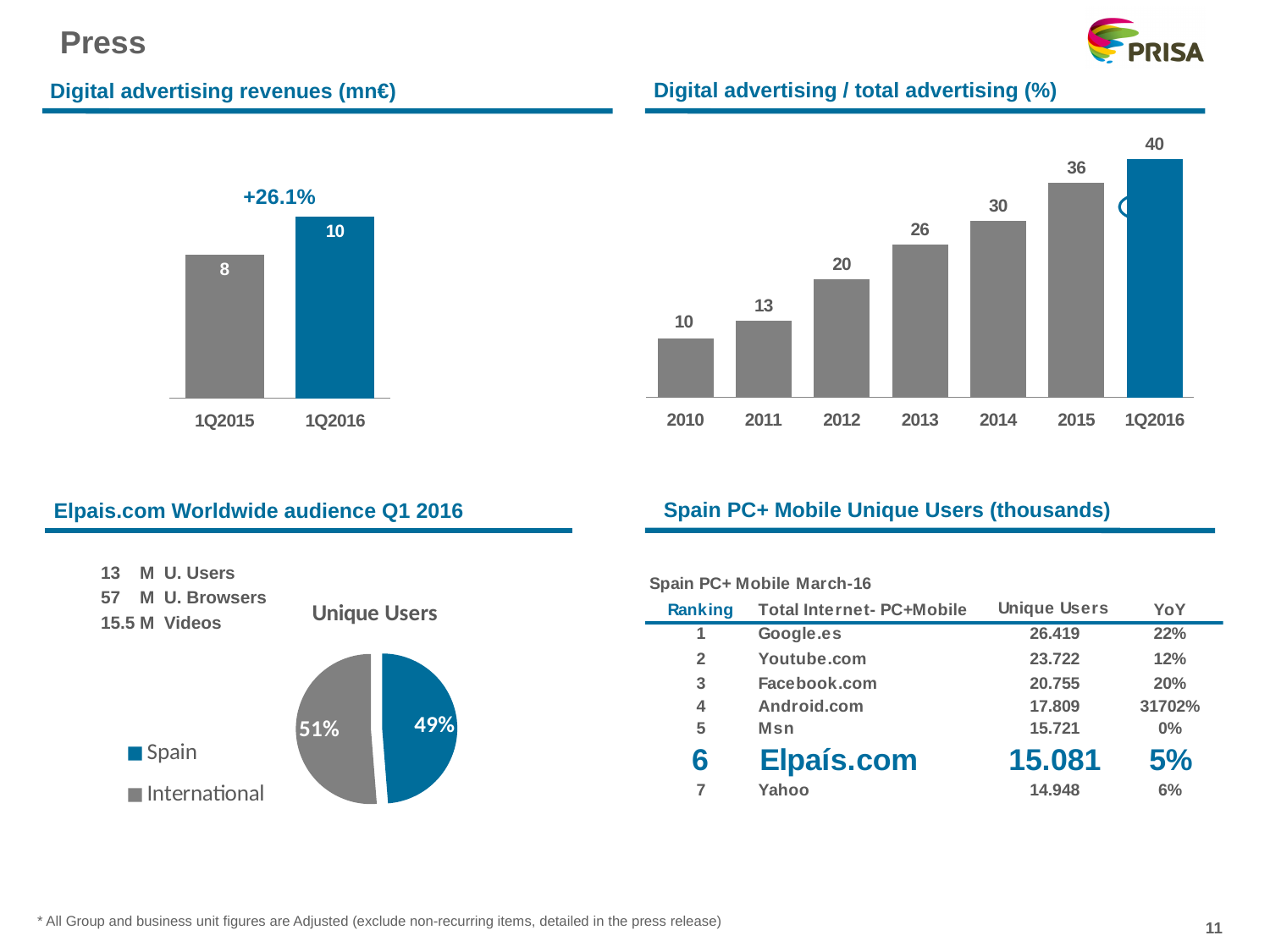
In the 'Digital advertising / total advertising (%)' chart, do the values rise or fall from 2010 to 1Q2016? rise In the 'Digital advertising / total advertising (%)' chart, which category has the highest value? 1Q2016 In the 'Digital advertising revenues (mn€)' chart, what is the value for 1Q2016? 10 In the 'Digital advertising revenues (mn€)' chart, what is the difference between the 1Q2016 and 1Q2015 values? 2 In the 'Digital advertising revenues (mn€)' chart, what growth percentage is shown above the bars? +26.1% In the 'Digital advertising revenues (mn€)' chart, what is the value for 1Q2015? 8 In the 'Digital advertising / total advertising (%)' chart, which category has the lowest value? 2010 In the 'Unique Users' pie chart, what share does Spain have? 49% What kind of chart is the 'Unique Users' chart on the slide? pie chart In the 'Digital advertising / total advertising (%)' chart, what is the difference between the 2015 and 2014 values? 6 In the 'Digital advertising / total advertising (%)' chart, what is the value for 2013? 26 In the 'Digital advertising / total advertising (%)' chart, how many bars are shown? 7